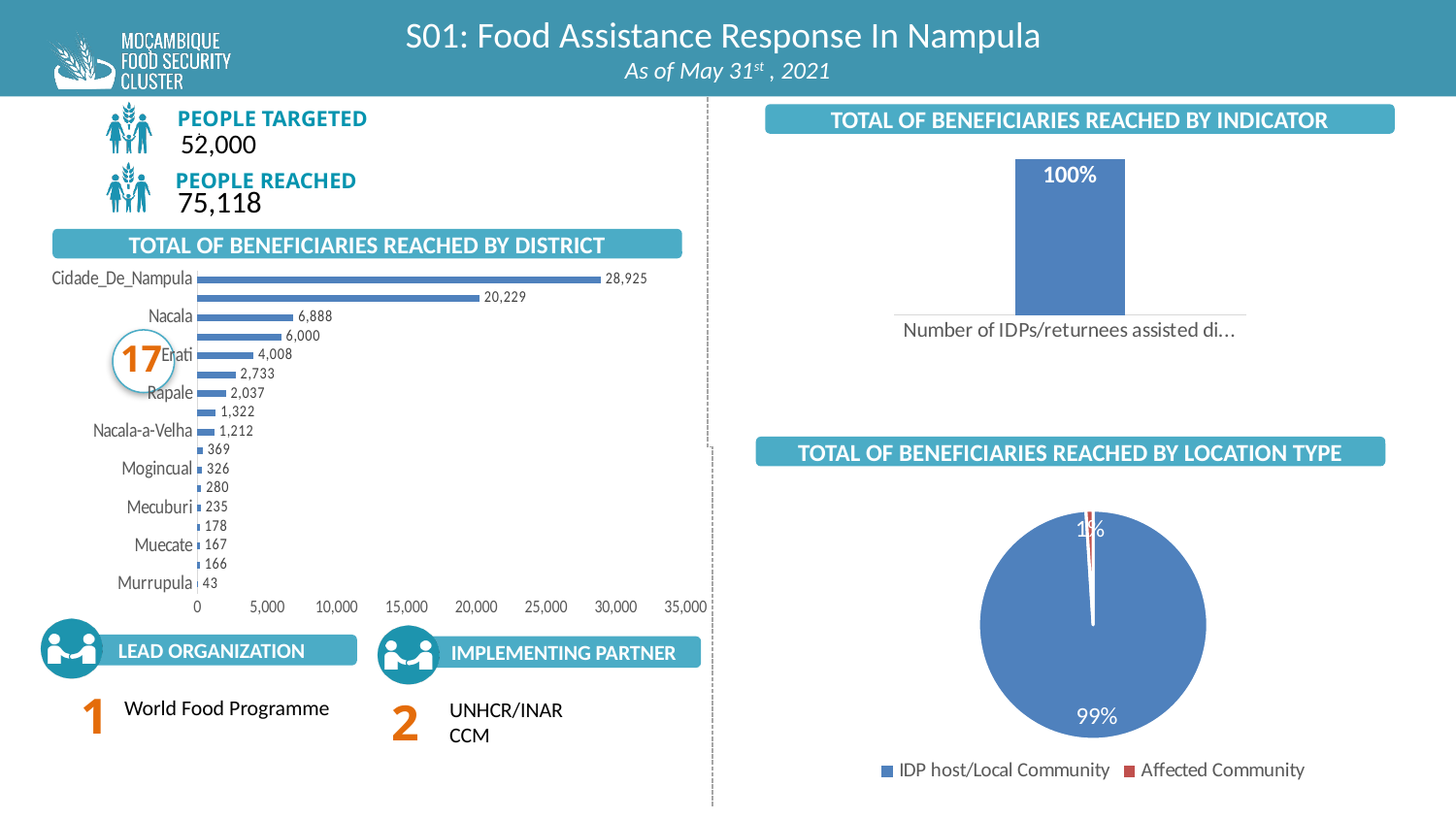
In the 'Total of beneficiaries reached by district' chart, which is larger, Mogincual or Mecuburi? Mogincual In the 'Total of beneficiaries reached by district' chart, what is the value for Murrupula? 43 In the 'Total of beneficiaries reached by district' chart, what is the difference between Cidade_De_Nampula and Nacala? 22,037 In the 'Total of beneficiaries reached by location type' pie chart, what share is IDP host/Local Community? 99% What kind of chart is 'Total of beneficiaries reached by district'? Bar chart In the 'Total of beneficiaries reached by district' chart, which labelled district has the lowest value? Murrupula In the 'Total of beneficiaries reached by indicator' chart, what value is shown for the single bar? 100% In the 'Total of beneficiaries reached by district' chart, how many bars are plotted? 17 In the 'Total of beneficiaries reached by district' chart, which district has the highest value? Cidade_De_Nampula In the 'Total of beneficiaries reached by district' chart, what is the value for Cidade_De_Nampula? 28,925 In the 'Total of beneficiaries reached by district' chart, what is the value for Nacala? 6,888 In the 'Total of beneficiaries reached by district' chart, what is the value for Rapale? 2,037